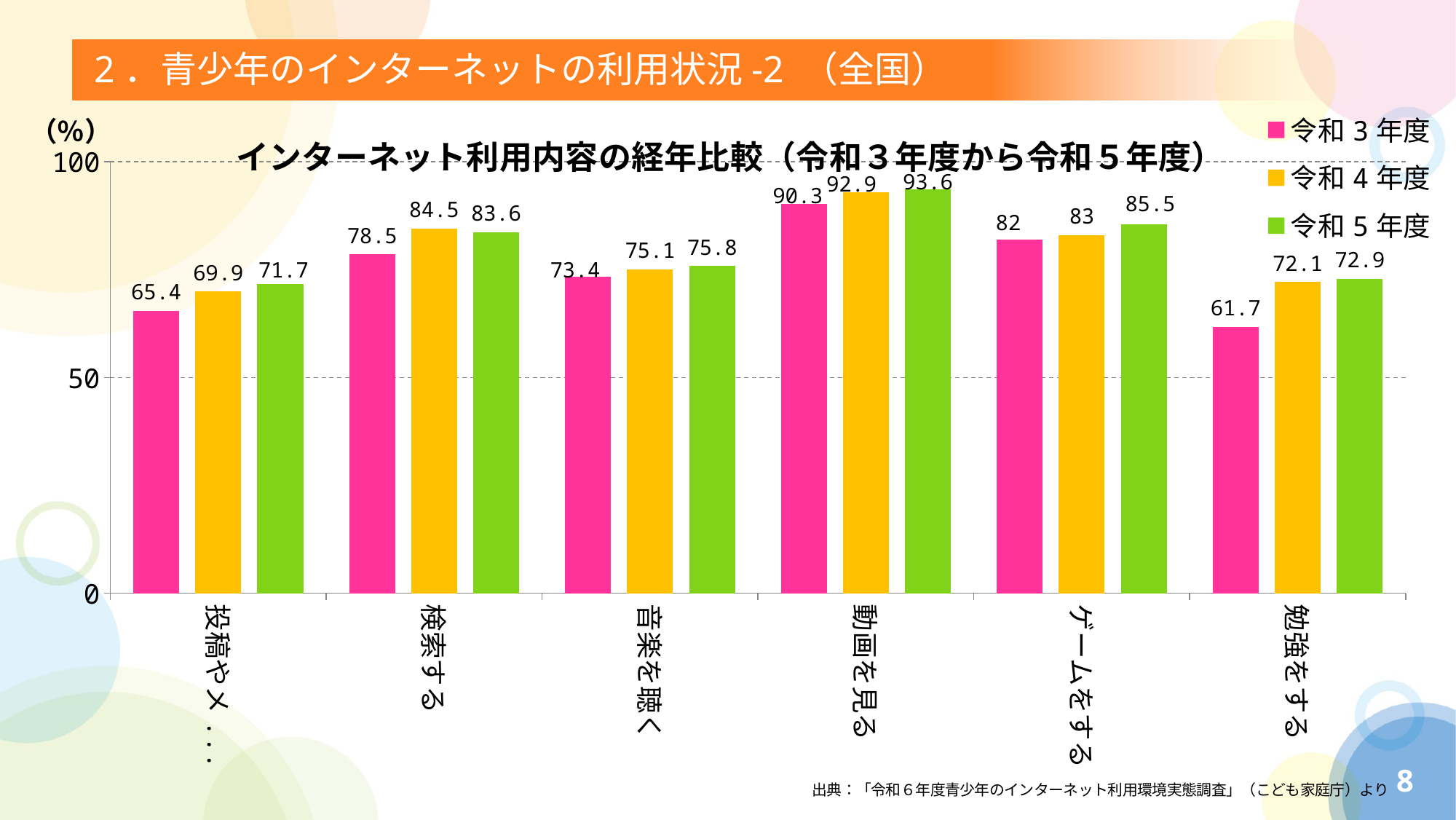
How many categories are shown on the x axis? 6 What is the difference between the 令和5年度 and 令和4年度 values for ゲームをする? 2.5 What is the difference between the 令和5年度 and 令和3年度 values for 勉強をする? 11.2 What kind of chart is shown on the slide? bar chart What is the 令和4年度 value for 検索する? 84.5 Is the 令和3年度 value for 音楽を聴く greater or less than 50? greater How many series does the legend list? 3 What is the 令和5年度 value for 動画を見る? 93.6 Which category has the highest 令和5年度 value? 動画を見る Which category has the lowest 令和3年度 value? 勉強をする For 検索する, which is larger: the 令和4年度 value or the 令和5年度 value? 令和4年度 What is the 令和3年度 value for 勉強をする? 61.7